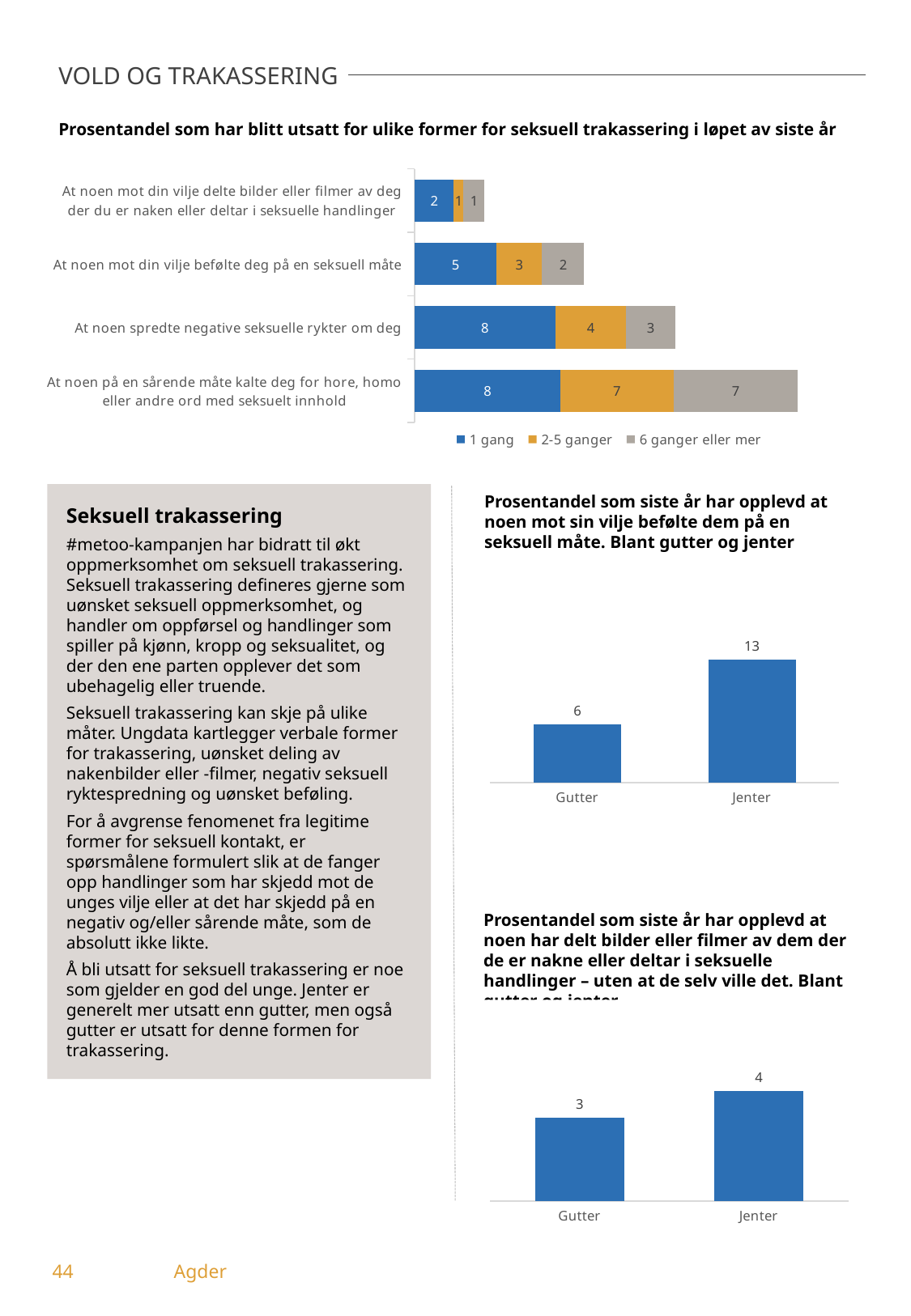
In the top chart, which category has the longest total bar? At noen på en sårende måte kalte deg for hore, homo eller andre ord med seksuelt innhold In the top chart, how many categories are shown? 4 In the top chart, what colour represents '2-5 ganger'? Orange In the middle chart on the right (about 'befølte dem på en seksuell måte'), what is the difference between Jenter and Gutter? 7 In the top chart, what is the value for '1 gang' for 'At noen spredte negative seksuelle rykter om deg'? 8 In the middle chart on the right (about 'befølte dem på en seksuell måte'), what is the value for Jenter? 13 In the top chart, what is the value for '6 ganger eller mer' for 'At noen mot din vilje befølte deg på en seksuell måte'? 2 In the top chart, what is the total of the stacked bar for 'At noen mot din vilje delte bilder eller filmer av deg der du er naken eller deltar i seksuelle handlinger'? 4 In the top chart, what is the total of the stacked bar for 'At noen på en sårende måte kalte deg for hore, homo eller andre ord med seksuelt innhold'? 22 In the top chart, how many series does the legend list? 3 What type of chart is the bottom chart on the right (about 'delt bilder eller filmer')? Bar chart In the bottom chart on the right (about 'delt bilder eller filmer'), which is larger, Gutter or Jenter? Jenter